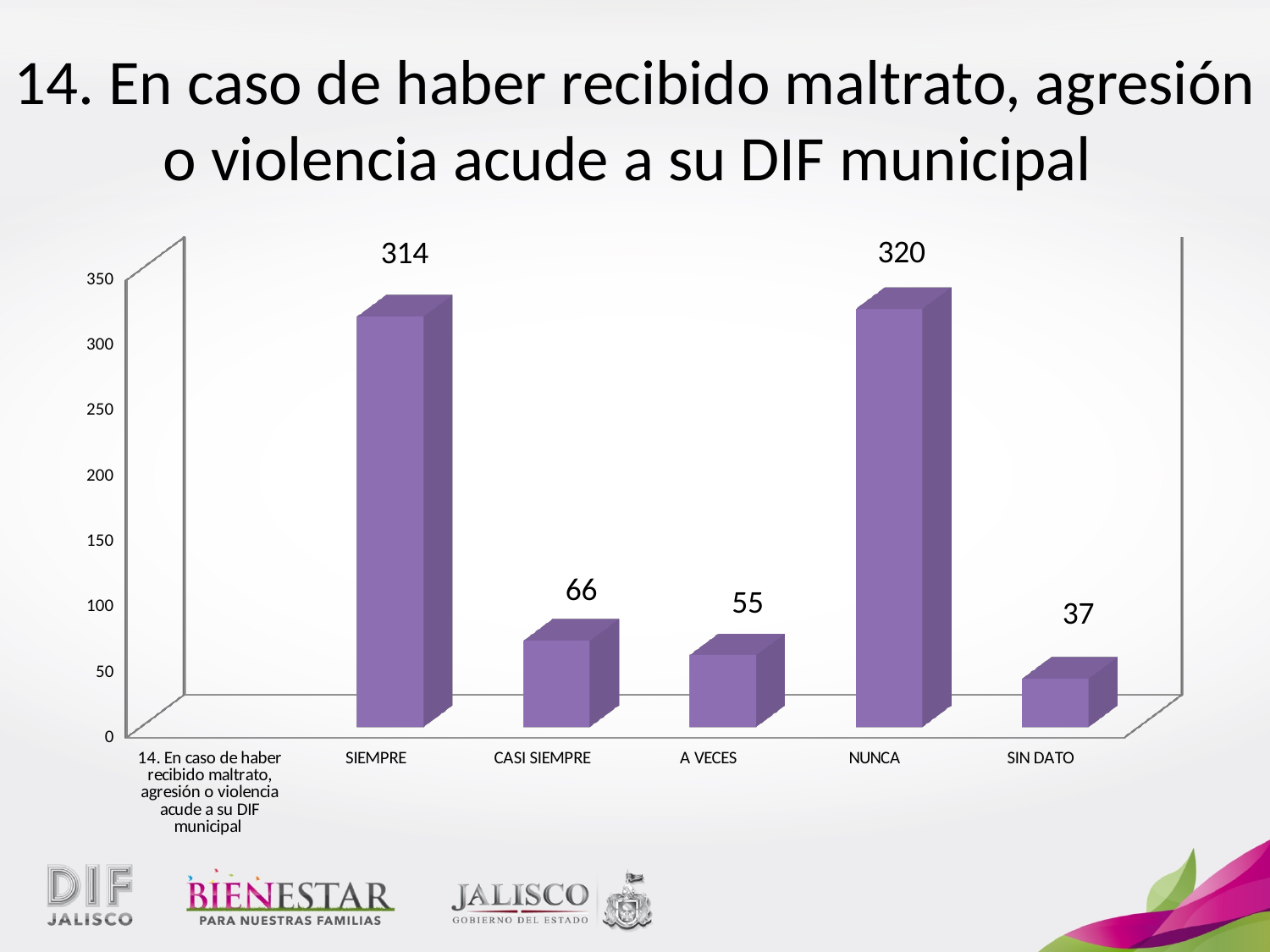
What is the value for A VECES? 55 What is the difference between the values for NUNCA and SIEMPRE? 6 What is the difference between the values for CASI SIEMPRE and A VECES? 11 Which category has the highest value? NUNCA Which category has the lowest value? SIN DATO What is the value for SIN DATO? 37 What is the value for SIEMPRE? 314 How many bars are plotted in the chart? 5 Which is larger, the value for CASI SIEMPRE or the value for A VECES? CASI SIEMPRE Is the value for SIN DATO greater or less than 50? less What kind of chart is shown on the slide? bar chart What is the value for NUNCA? 320